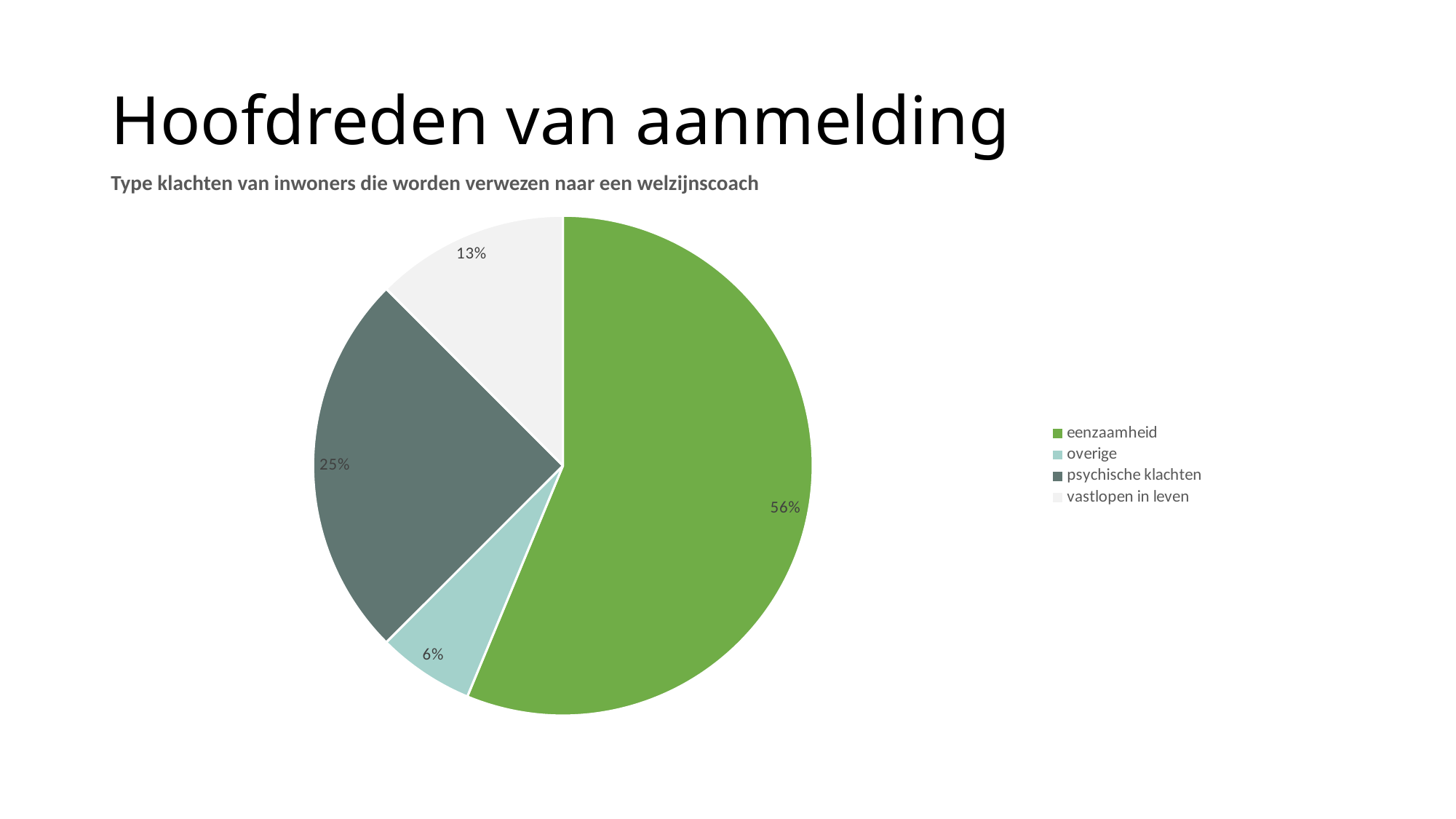
What kind of chart is shown on the slide? pie chart Which is larger, the slice for vastlopen in leven or the slice for overige? vastlopen in leven What share of the pie does psychische klachten represent? 25% Which category has the largest slice of the pie? eenzaamheid What is the subtitle shown above the chart? Type klachten van inwoners die worden verwezen naar een welzijnscoach What share of the pie does eenzaamheid represent? 56% How many categories does the pie chart show? 4 What is the difference in percentage points between eenzaamheid and psychische klachten? 31 What share of the pie does vastlopen in leven represent? 13% Which category has the smallest slice of the pie? overige What is the difference in percentage points between psychische klachten and vastlopen in leven? 12